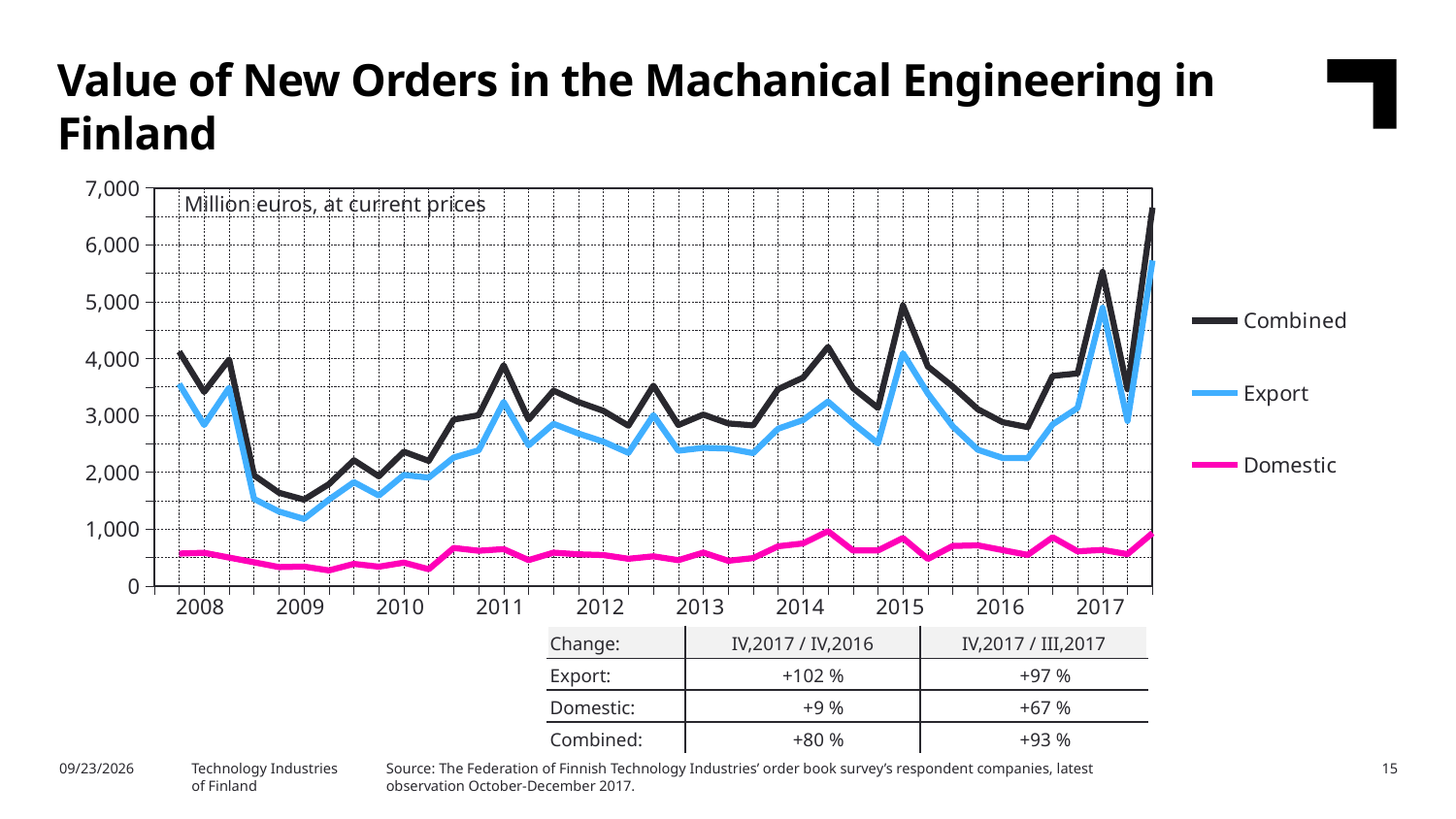
Which series has the lowest values throughout the chart? Domestic How many years are labelled on the x axis? 10 What kind of chart is shown on the slide? Line chart How many series does the legend list? 3 What unit label is printed inside the plot area? Million euros, at current prices Which series has the highest values throughout the chart? Combined Which is larger at the end of 2017, Export or Domestic? Export Is the value for Combined at the last point in 2017 greater or less than 6,000? greater Does the Combined series rise or fall from 2008 to 2009? Fall Which series are listed in the legend? Combined, Export, Domestic Is the value for Domestic in 2009 greater or less than 1,000? less Is the value for Export at the last point in 2017 greater or less than 5,000? greater